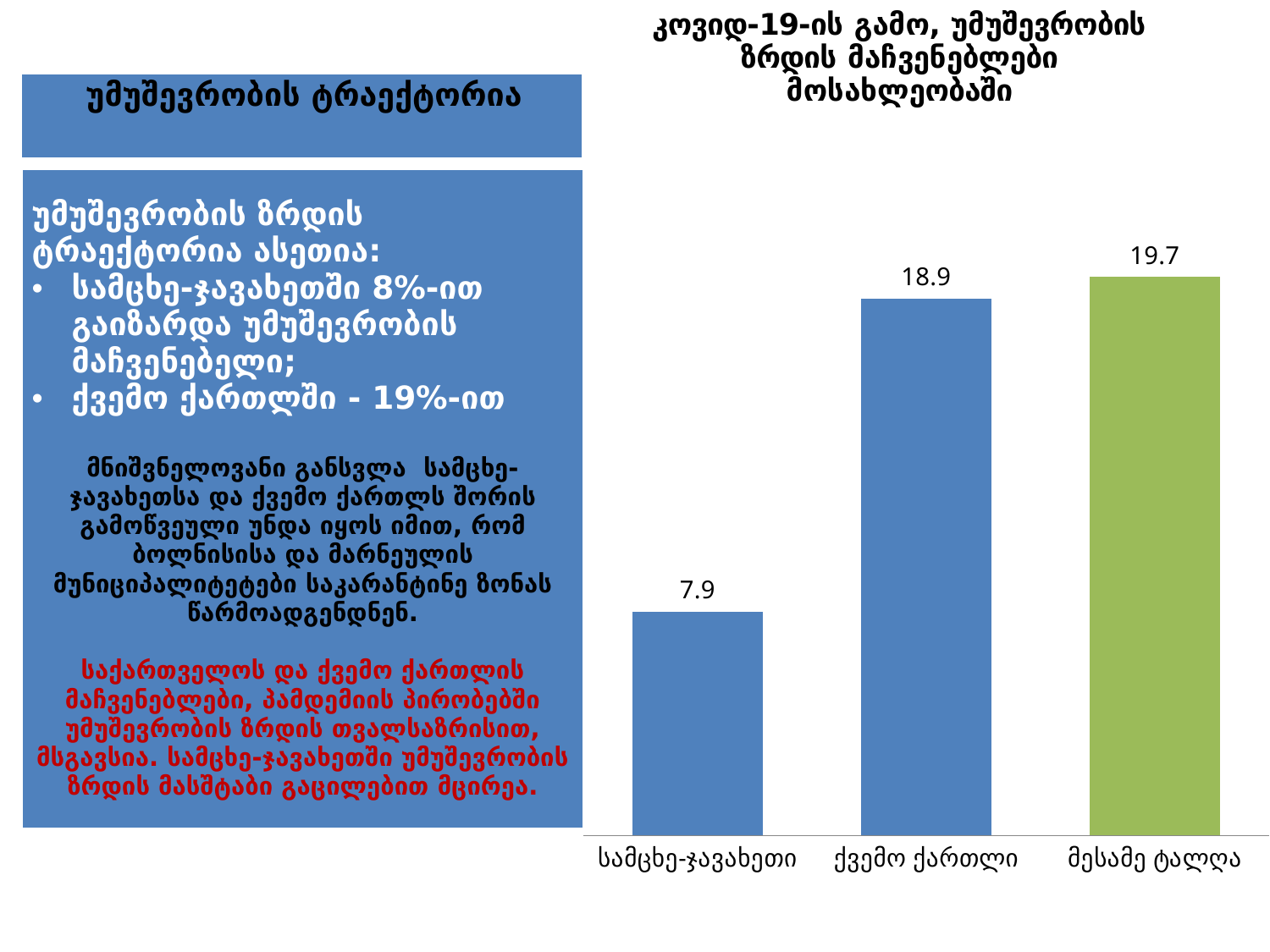
What colour is the bar for მესამე ტალღა? Green Which is larger, the value for ქვემო ქართლი or the value for სამცხე-ჯავახეთი? ქვემო ქართლი How many categories are shown in the chart? 3 What is the difference between the values for მესამე ტალღა and ქვემო ქართლი? 0.8 What is the difference between the values for ქვემო ქართლი and სამცხე-ჯავახეთი? 11.0 Do the values rise or fall from left to right across the categories? Rise Which category has the lowest value? სამცხე-ჯავახეთი Which category has the highest value? მესამე ტალღა What is the value for მესამე ტალღა? 19.7 What kind of chart is shown on the slide? Bar chart What is the value for სამცხე-ჯავახეთი? 7.9 What is the value for ქვემო ქართლი? 18.9